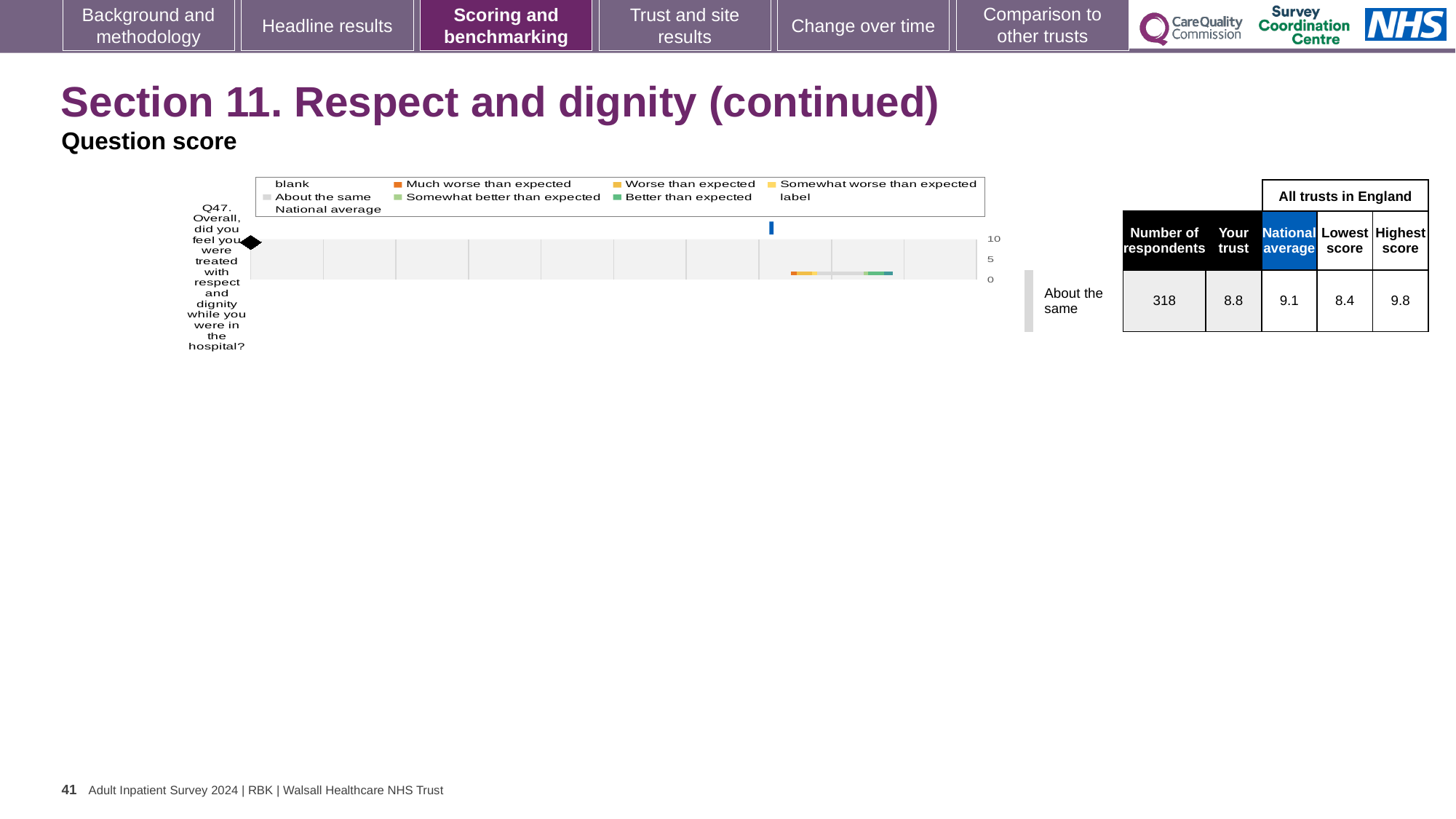
How many questions (categories) are plotted on the chart? 1 What is the lowest score among all trusts in England for Q47? 8.4 What is the highest tick value shown on the chart's axis? 10 What is the number of respondents for Q47 in the table beside the chart? 318 Which is larger for Q47, the 'Your trust' score or the national average? National average What is the 'Your trust' score for Q47 in the table beside the chart? 8.8 What is the highest score among all trusts in England for Q47? 9.8 Which question number is plotted on the chart? Q47 What kind of chart is shown on the slide? bar chart What is the difference between the highest score and the lowest score for Q47? 1.4 What is the national average score for Q47 in the table beside the chart? 9.1 What benchmark category is shown for Q47 next to the chart? About the same